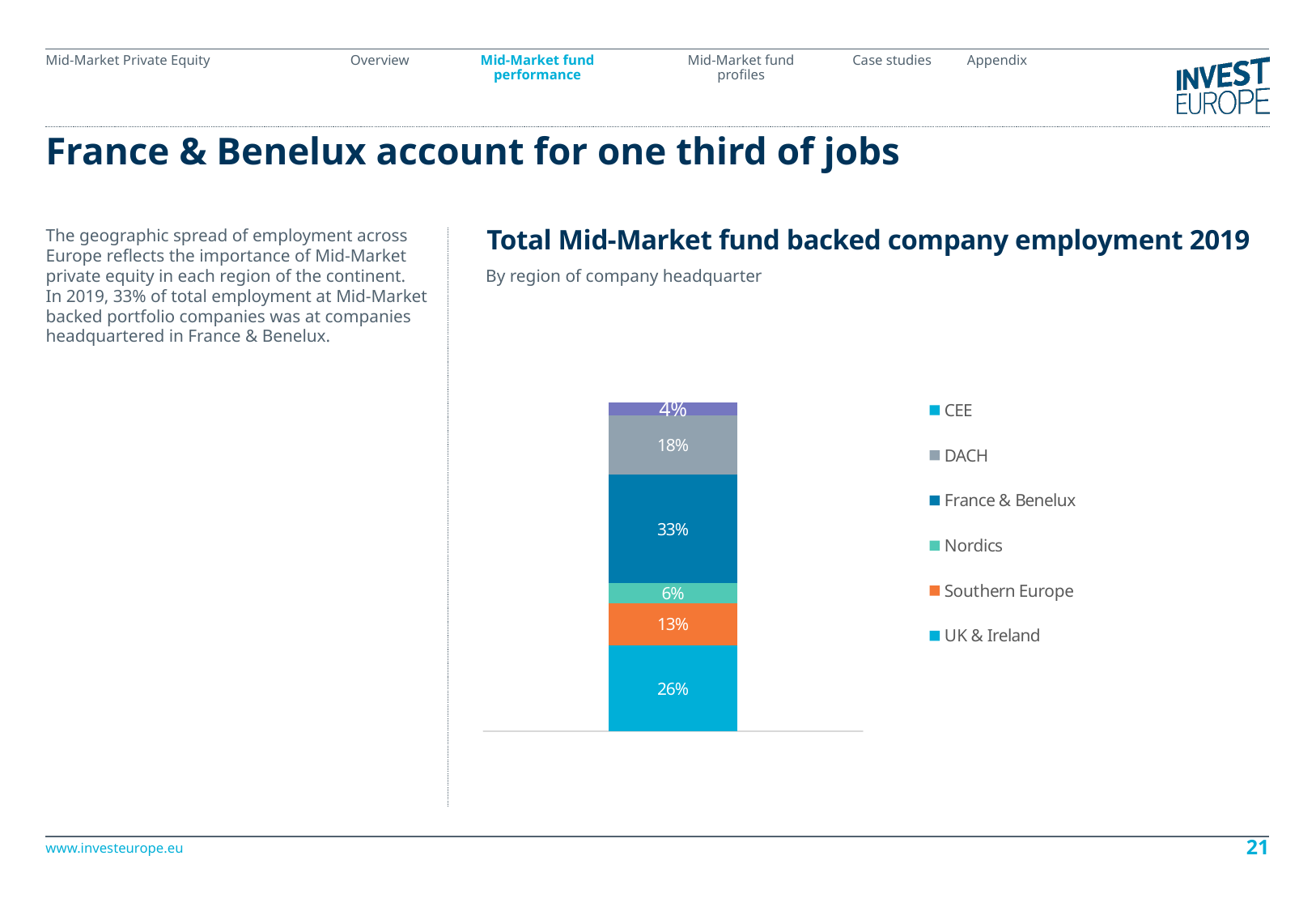
What is the difference between the DACH and Nordics shares? 12% What type of chart is shown? Stacked bar chart What is the total of all segments in the stacked bar? 100% How many regions does the legend list? 6 Which is larger, the share for Southern Europe or the share for Nordics? Southern Europe What share of employment is attributed to France & Benelux? 33% What is the value for Southern Europe? 13% Which region has the smallest share of employment? CEE What percentage is shown for DACH? 18% What is the value shown for UK & Ireland? 26% Which region has the largest share of employment? France & Benelux What is the difference between the shares for France & Benelux and UK & Ireland? 7%